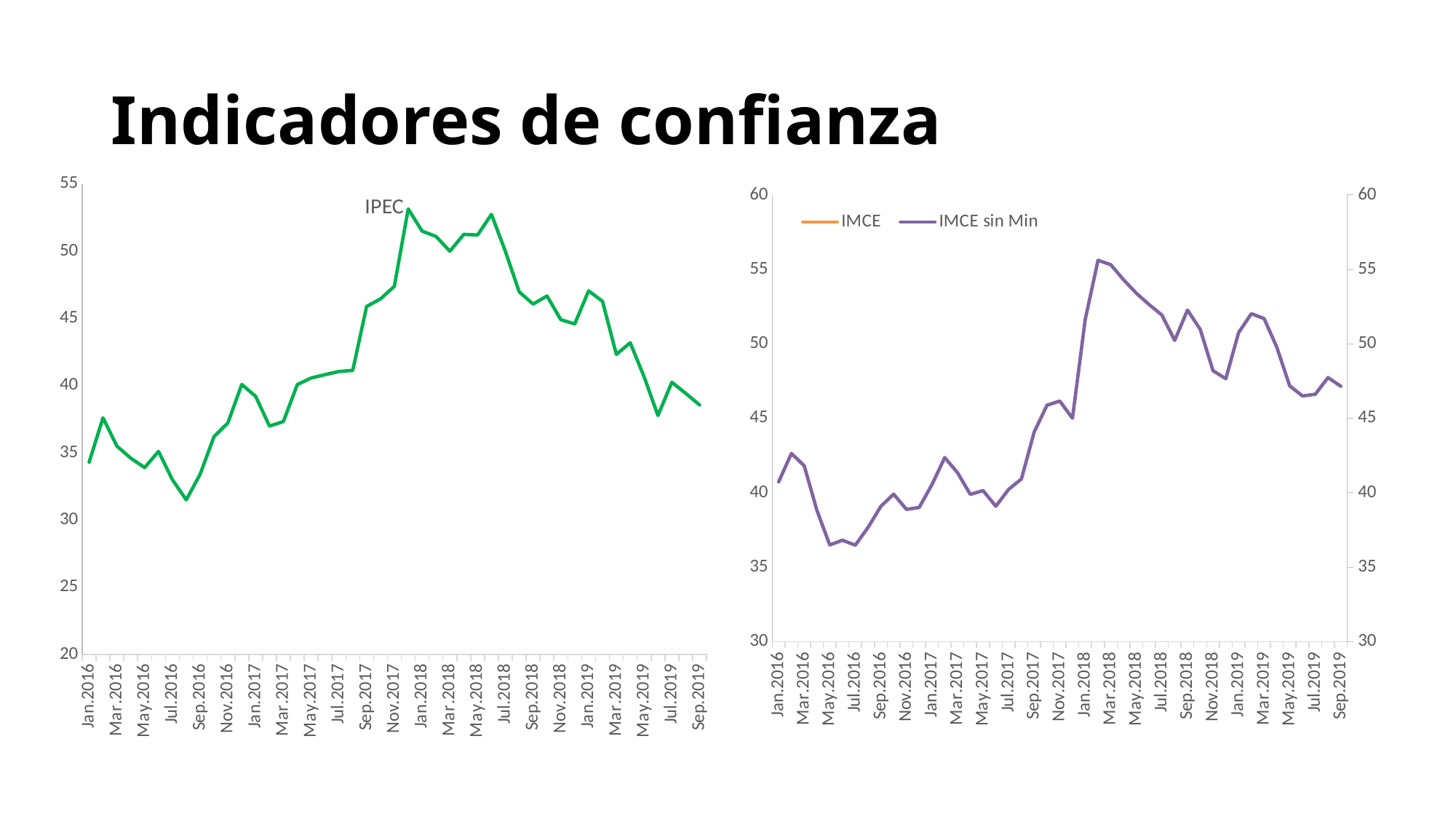
In the right chart, is the IMCE sin Min value for Mar.2018 greater or less than 50? greater What is the title of the slide containing the two charts? Indicadores de confianza In the right chart, how many series does the legend list? 2 In the right chart, does the IMCE sin Min line overall rise or fall from Mar.2018 to Sep.2019? fall In the left chart (IPEC), is the value for Jan.2019 greater or less than 45? greater In the left chart (IPEC), is the value for Sep.2019 greater or less than 40? less What kind of chart is the right chart with the IMCE legend? line chart What kind of chart is the left chart labelled IPEC? line chart In the left chart (IPEC), does the line overall rise or fall from Jan.2018 to Sep.2019? fall